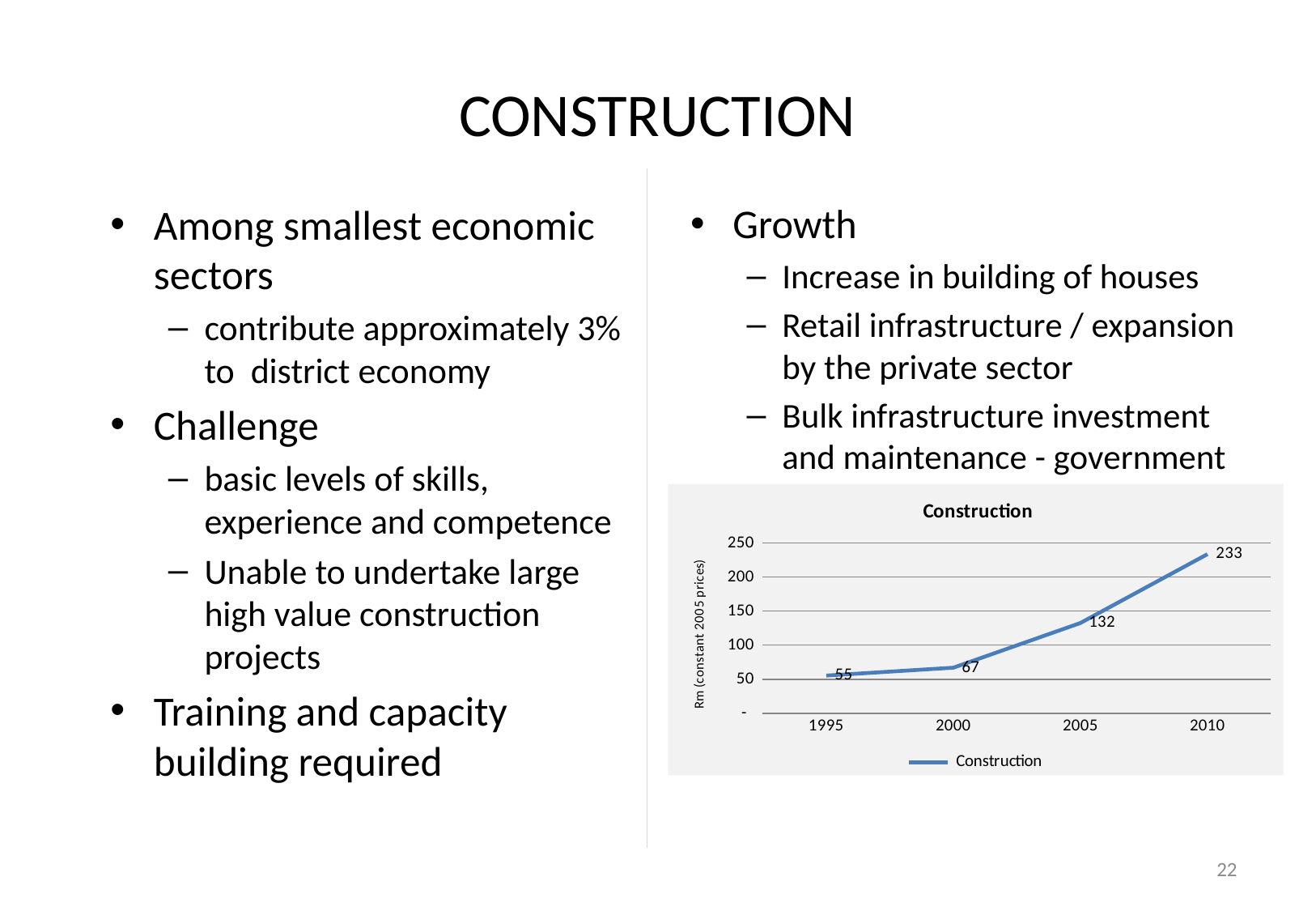
What kind of chart is the Construction chart? line chart What is the difference between the Construction values for 2010 and 2005? 101 What is the value for Construction in 2005? 132 What is the difference between the Construction values for 2000 and 1995? 12 Which is larger, the Construction value for 2005 or for 2000? 2005 Which year has the highest Construction value? 2010 What is the value for Construction in 1995? 55 Do the Construction values rise or fall from 1995 to 2010? rise Is the value for Construction in 2005 greater or less than 100? greater Which year has the lowest Construction value? 1995 How many years are plotted on the Construction chart? 4 What is the value for Construction in 2010? 233